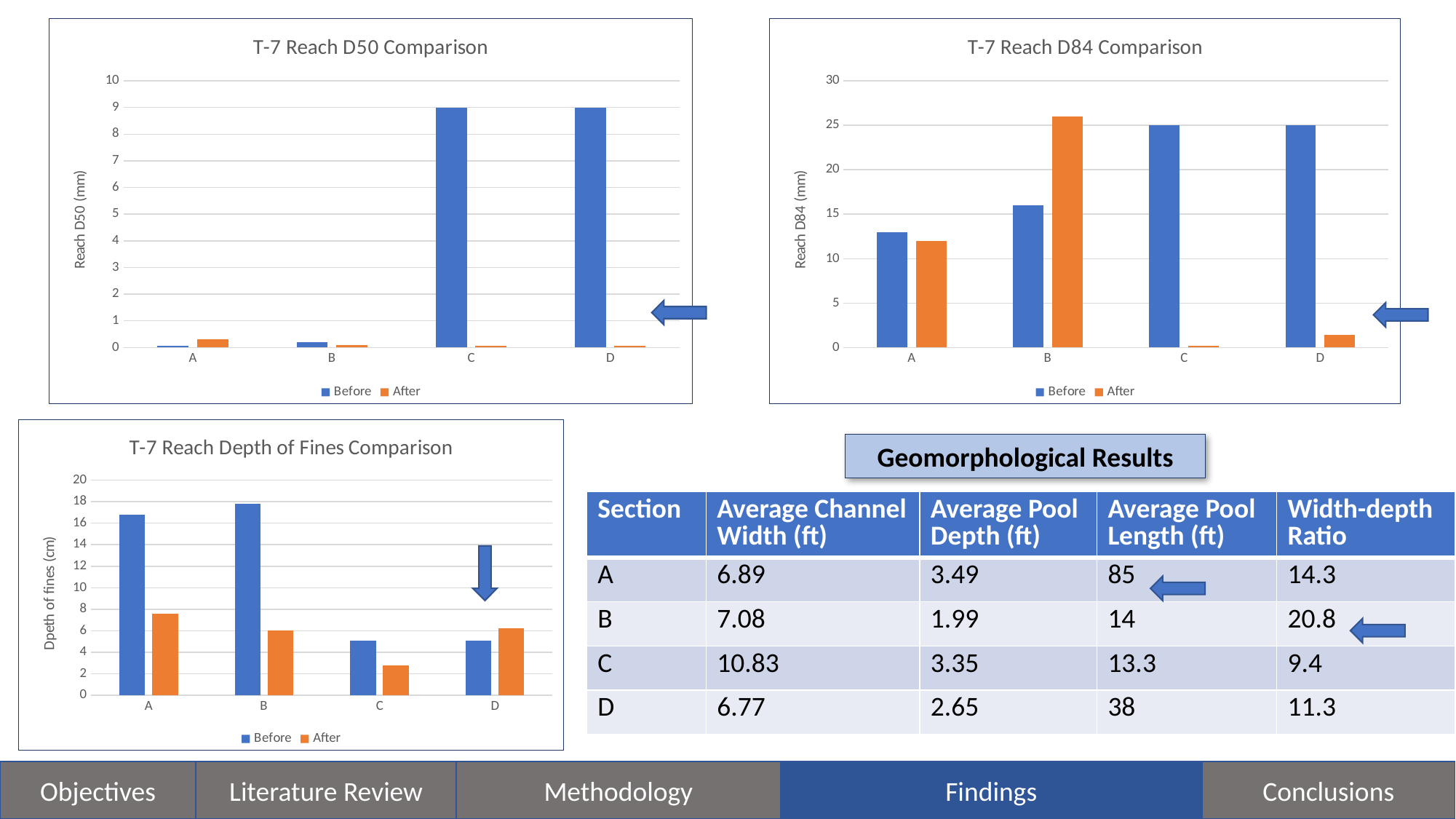
In the T-7 Reach D84 Comparison chart, which category has the highest After value? B What kind of chart is the T-7 Reach D84 Comparison chart? bar chart In the T-7 Reach D50 Comparison chart, what is the Before value for C? 9 In the T-7 Reach Depth of Fines Comparison chart, how many categories are shown on the x axis? 4 In the T-7 Reach D50 Comparison chart, which category has the highest After value? A In the T-7 Reach D84 Comparison chart, which is larger for A, the Before value or the After value? Before In the T-7 Reach Depth of Fines Comparison chart, is the Before value for A greater or less than 16? greater In the T-7 Reach Depth of Fines Comparison chart, which category has the highest Before value? B In the T-7 Reach D50 Comparison chart, how many series does the legend list? 2 What is the y-axis label of the T-7 Reach Depth of Fines Comparison chart? Dpeth of fines (cm) In the T-7 Reach D84 Comparison chart, what is the Before value for C? 25 In the T-7 Reach D84 Comparison chart, is the Before value for B greater or less than 15? greater